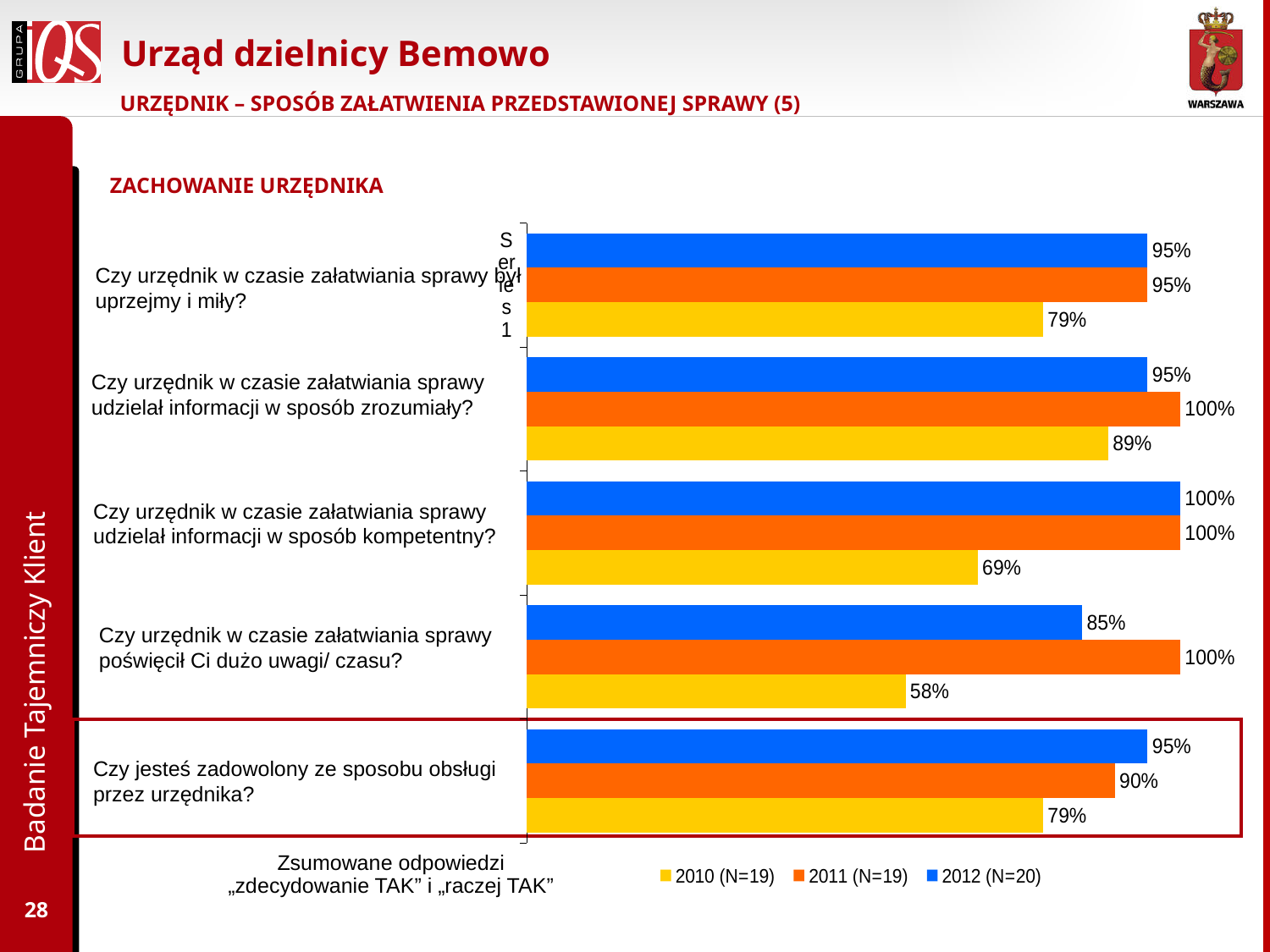
What is the difference between the 2011 and 2010 values for "Czy urzędnik w czasie załatwiania sprawy poświęcił Ci dużo uwagi/ czasu?"? 42% What is the 2010 value for "Czy urzędnik w czasie załatwiania sprawy poświęcił Ci dużo uwagi/ czasu?"? 58% How many question categories are plotted on the chart? 5 What is the difference between the 2012 and 2010 values for "Czy urzędnik w czasie załatwiania sprawy był uprzejmy i miły?"? 16% What is the 2011 value for "Czy jesteś zadowolony ze sposobu obsługi przez urzędnika?"? 90% For "Czy jesteś zadowolony ze sposobu obsługi przez urzędnika?", which is larger: the 2012 value or the 2011 value? 2012 What sample size (N) does the legend give for the 2012 series? N=20 What is the 2010 value for "Czy urzędnik w czasie załatwiania sprawy udzielał informacji w sposób kompetentny?"? 69% What kind of chart is shown on the slide? bar chart How many series does the legend list? 3 Which question has the lowest 2010 value? Czy urzędnik w czasie załatwiania sprawy poświęcił Ci dużo uwagi/ czasu? What is the 2012 value for "Czy urzędnik w czasie załatwiania sprawy udzielał informacji w sposób zrozumiały?"? 95%